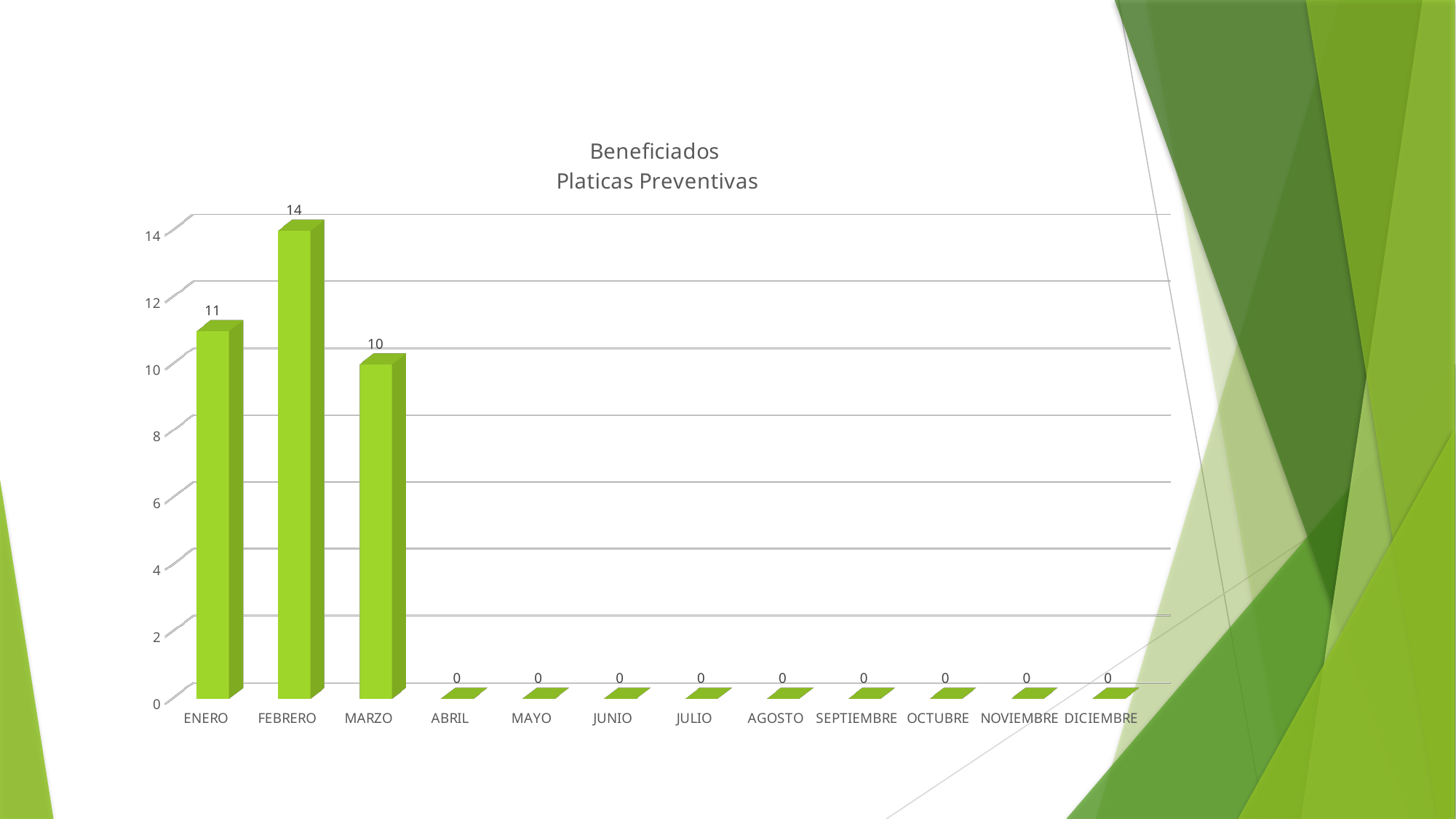
What is the difference between the values for FEBRERO and MARZO? 4 How many months are shown on the x axis? 12 Which month has the highest value? FEBRERO Is the value for FEBRERO greater or less than 12? greater What is the value for MARZO? 10 What is the value for ENERO? 11 What is the title of the chart? Beneficiados Platicas Preventivas What is the value for JULIO? 0 What kind of chart is shown on the slide? bar chart What is the difference between the values for ENERO and MARZO? 1 Which is larger, the value for ENERO or the value for MARZO? ENERO What is the value for FEBRERO? 14